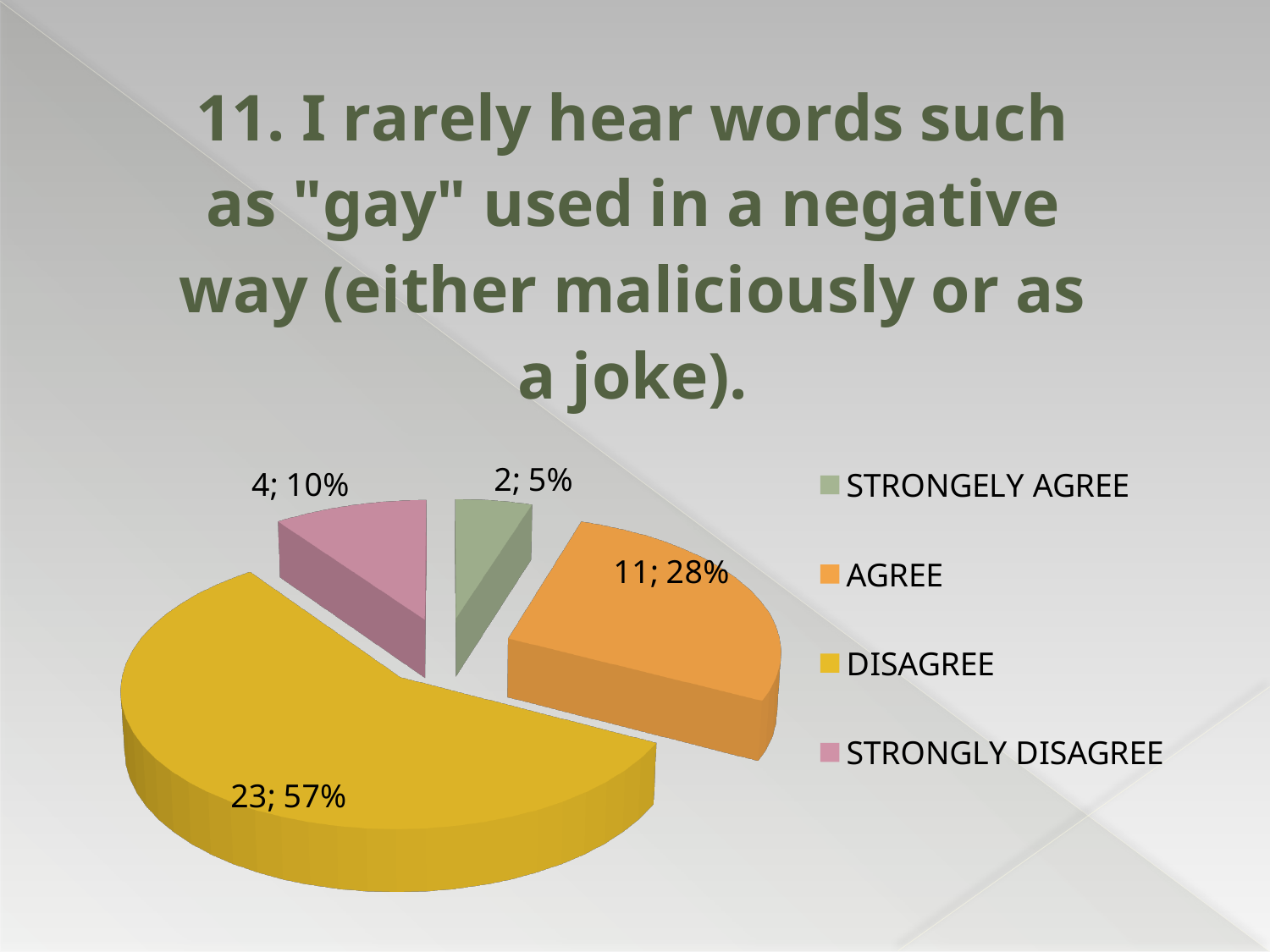
How many categories does the pie chart have? 4 What colour is the DISAGREE slice? yellow How many respondents chose DISAGREE? 23 Which has more respondents, AGREE or STRONGLY DISAGREE? AGREE What kind of chart is shown on the slide? pie chart What percentage of responses is STRONGLY DISAGREE? 10% What is the difference in count between DISAGREE and AGREE? 12 What is the total number of respondents across all slices? 40 What percentage of responses is AGREE? 28% Which response category has the smallest slice? STRONGLY AGREE Which response category has the largest slice? DISAGREE How many respondents chose STRONGLY AGREE? 2